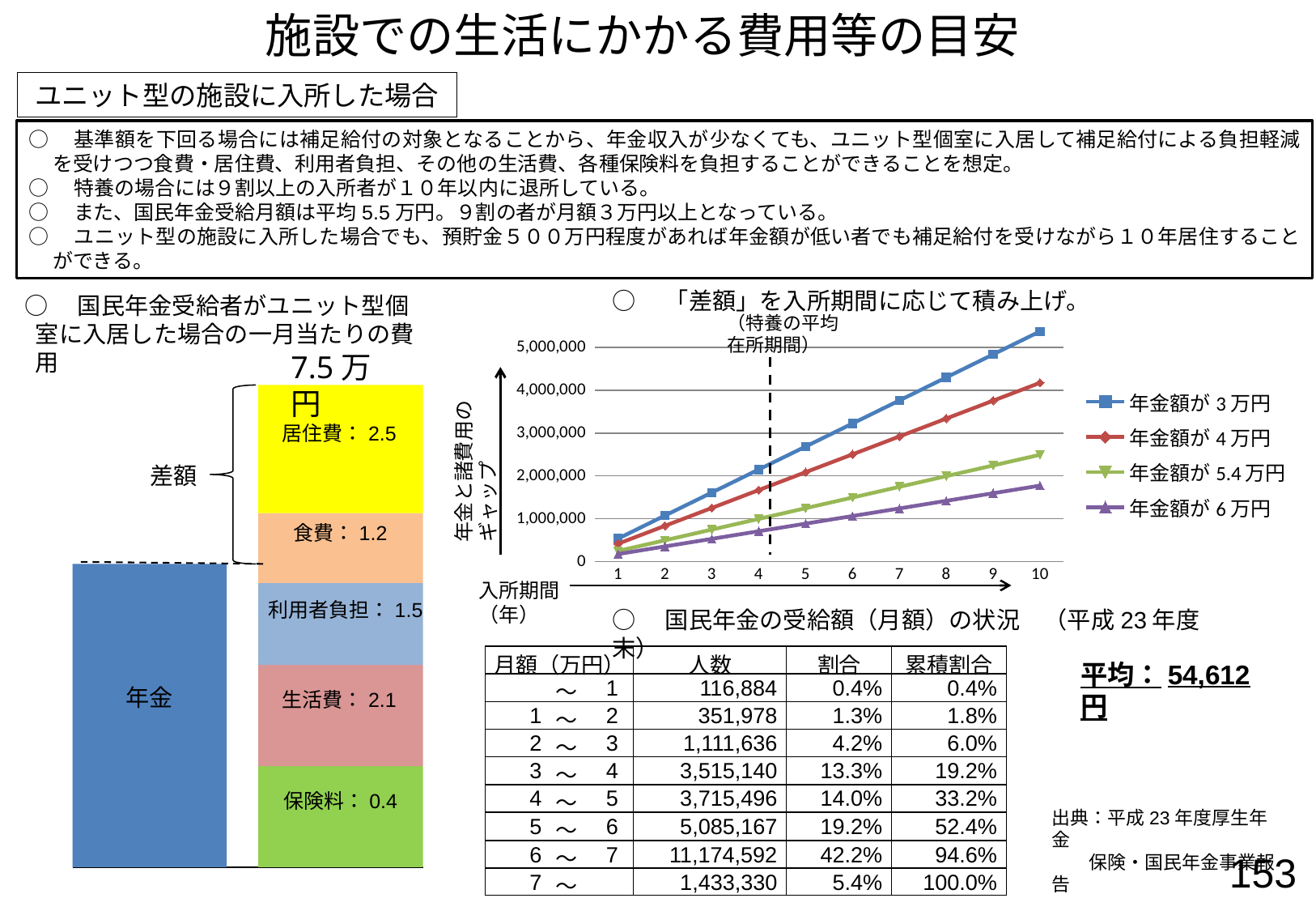
In the stacked bar chart on the left, what is the value for 保険料? 0.4 In the stacked bar chart on the left, which cost segment is the smallest? 保険料 In the line chart on the right, is the value for 年金額が6万円 at year 10 greater or less than 2,000,000? less In the stacked bar chart on the left, what is the value for 居住費? 2.5 In the stacked bar chart on the left, what is the value for 生活費? 2.1 In the stacked bar chart on the left, which is larger, 利用者負担 or 食費? 利用者負担 In the stacked bar chart on the left, which cost segment is the largest? 居住費 In the line chart on the right, how many series does the legend list? 4 In the stacked bar chart on the left, what is the total of the stacked cost bar? 7.5万円 In the line chart on the right, is the value for 年金額が3万円 at year 10 greater or less than 5,000,000? greater In the line chart on the right, do the values rise or fall as the 入所期間 increases? rise In the stacked bar chart on the left, what is the difference between 居住費 and 食費? 1.3